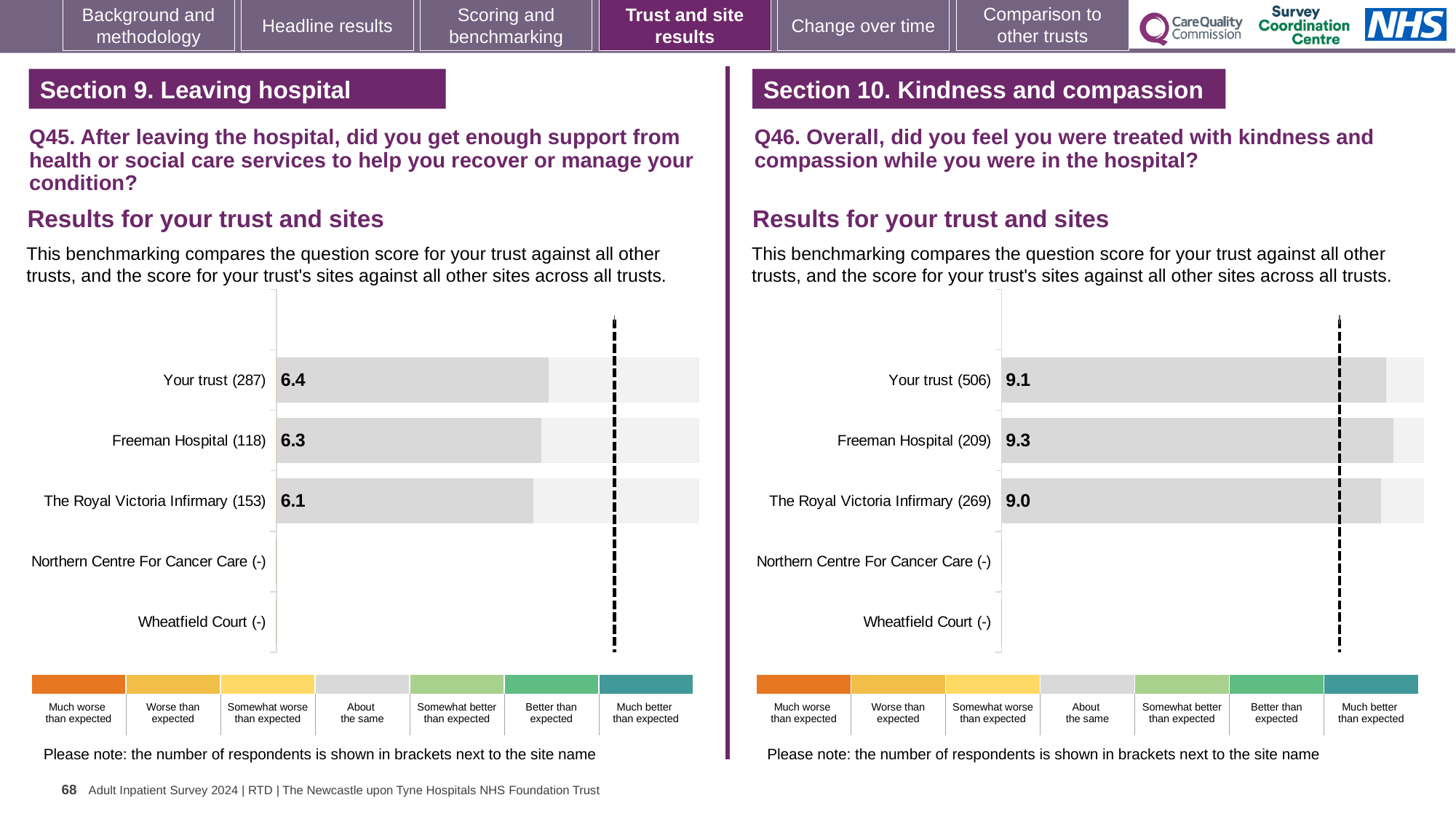
In the Q45 chart on the left, which site or trust has the lowest score? The Royal Victoria Infirmary What kind of chart is used for the Q46 results on the right? Bar chart In the Q45 chart on the left, how many respondents are shown in brackets for Freeman Hospital? 118 In the Q45 chart on the left, what is the score for The Royal Victoria Infirmary? 6.1 In the Q46 chart on the right, which site or trust has the highest score? Freeman Hospital In the Q46 chart on the right, what is the score for Freeman Hospital? 9.3 In the Q46 chart on the right, which has the higher score, Your trust or Freeman Hospital? Freeman Hospital In the Q45 chart on the left, what is the difference between the scores for Your trust and Freeman Hospital? 0.1 How many site or trust categories are listed on the y axis of the Q45 chart on the left? 5 In the Q46 chart on the right, what is the score for The Royal Victoria Infirmary? 9.0 In the Q46 chart on the right, what is the difference between the scores for Freeman Hospital and The Royal Victoria Infirmary? 0.3 In the Q45 chart on the left, what is the score for Your trust? 6.4